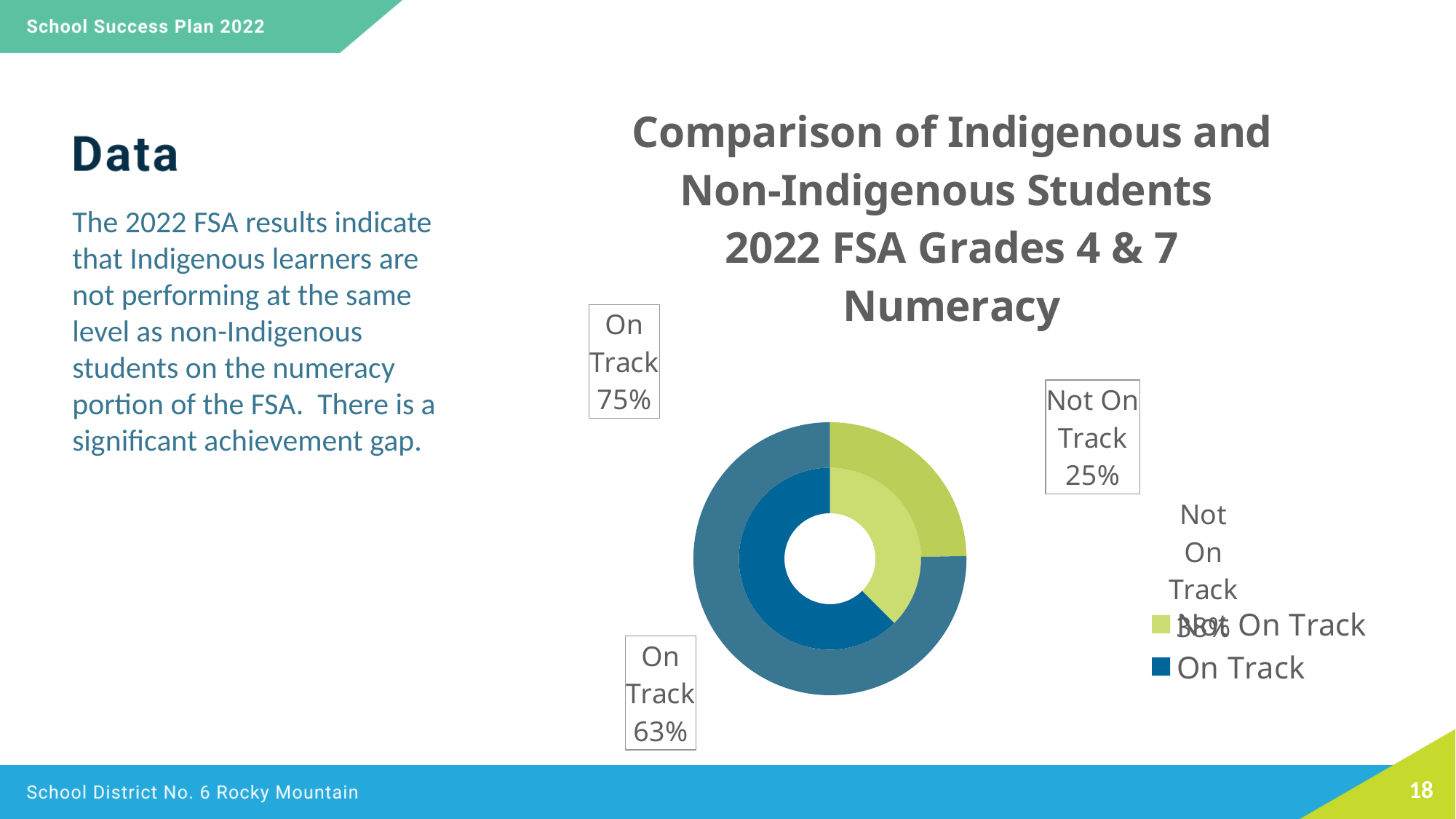
How many categories does each ring of the doughnut chart contain? 2 What is the On Track value shown for the inner ring of the doughnut chart? 63% Which ring has the larger On Track share, the outer ring or the inner ring? Outer ring What colour represents On Track in the chart? Blue In the outer ring, which category is larger, On Track or Not On Track? On Track In the outer ring, what is the difference between the On Track and Not On Track values? 50 percentage points What kind of chart is shown on the slide? Doughnut chart What is the On Track value shown for the outer ring of the doughnut chart? 75% What is the Not On Track value shown for the outer ring of the doughnut chart? 25% What do the On Track and Not On Track values in the outer ring add up to? 100% What is the title of the chart? Comparison of Indigenous and Non-Indigenous Students 2022 FSA Grades 4 & 7 Numeracy How many entries does the chart's legend list? 2